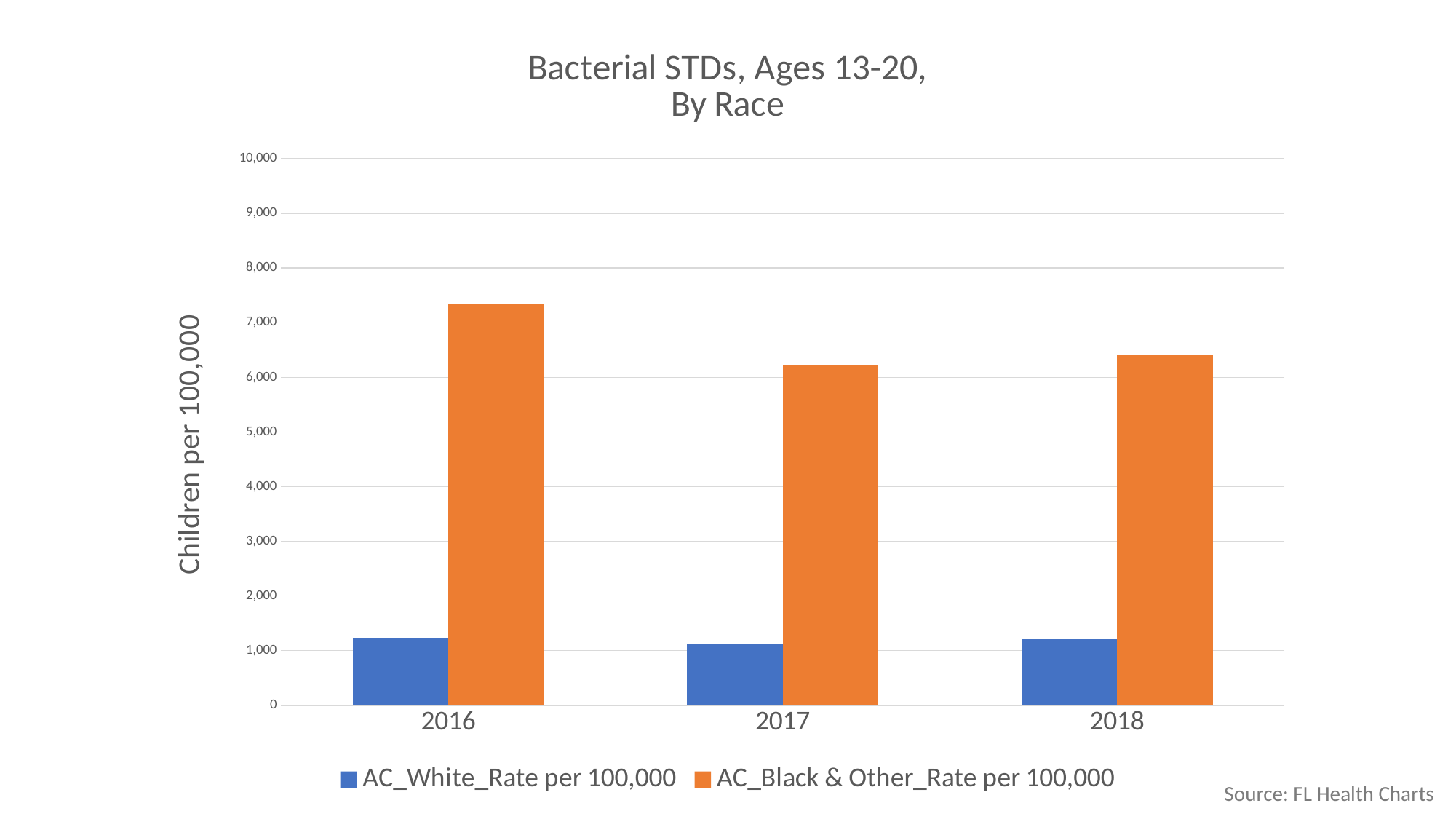
How many series does the legend list? 2 In which year is the AC_White_Rate per 100,000 lowest? 2017 Does the AC_Black & Other_Rate per 100,000 rise or fall from 2016 to 2017? fall What kind of chart is shown on the slide? bar chart In which year is the AC_Black & Other_Rate per 100,000 highest? 2016 In which year is the AC_Black & Other_Rate per 100,000 lowest? 2017 What is the label of the vertical axis? Children per 100,000 Is the AC_Black & Other_Rate per 100,000 value for 2016 greater or less than 7,000? greater Is the AC_White_Rate per 100,000 value for 2018 greater or less than 2,000? less How many years are shown on the x axis? 3 What is the title of the chart? Bacterial STDs, Ages 13-20, By Race In 2016, which series has the larger value, AC_White_Rate per 100,000 or AC_Black & Other_Rate per 100,000? AC_Black & Other_Rate per 100,000